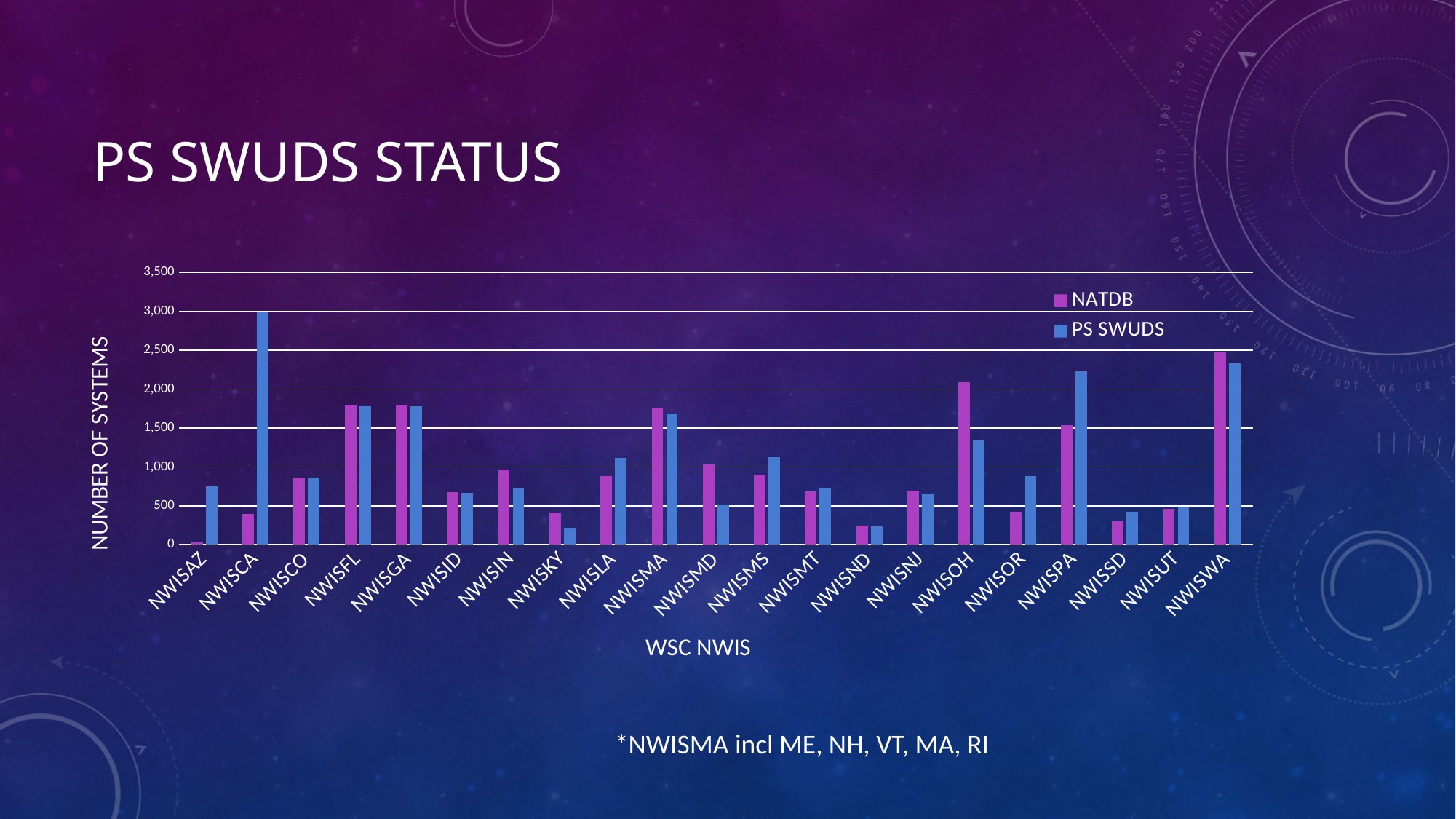
How many series does the chart legend list? 2 For NWISPA, which series has the larger value, NATDB or PS SWUDS? PS SWUDS Which category has the highest PS SWUDS value? NWISCA What is the label of the y axis? NUMBER OF SYSTEMS Is the NATDB value for NWISOH greater or less than 2,000? greater Is the PS SWUDS value for NWISCA greater or less than 2,500? greater Which category has the highest NATDB value? NWISWA For NWISOH, which series has the larger value, NATDB or PS SWUDS? NATDB How many WSC NWIS categories are shown on the x axis? 21 Is the NATDB value for NWISND greater or less than 500? less Which category has the lowest NATDB value? NWISAZ What kind of chart is shown on the slide? bar chart